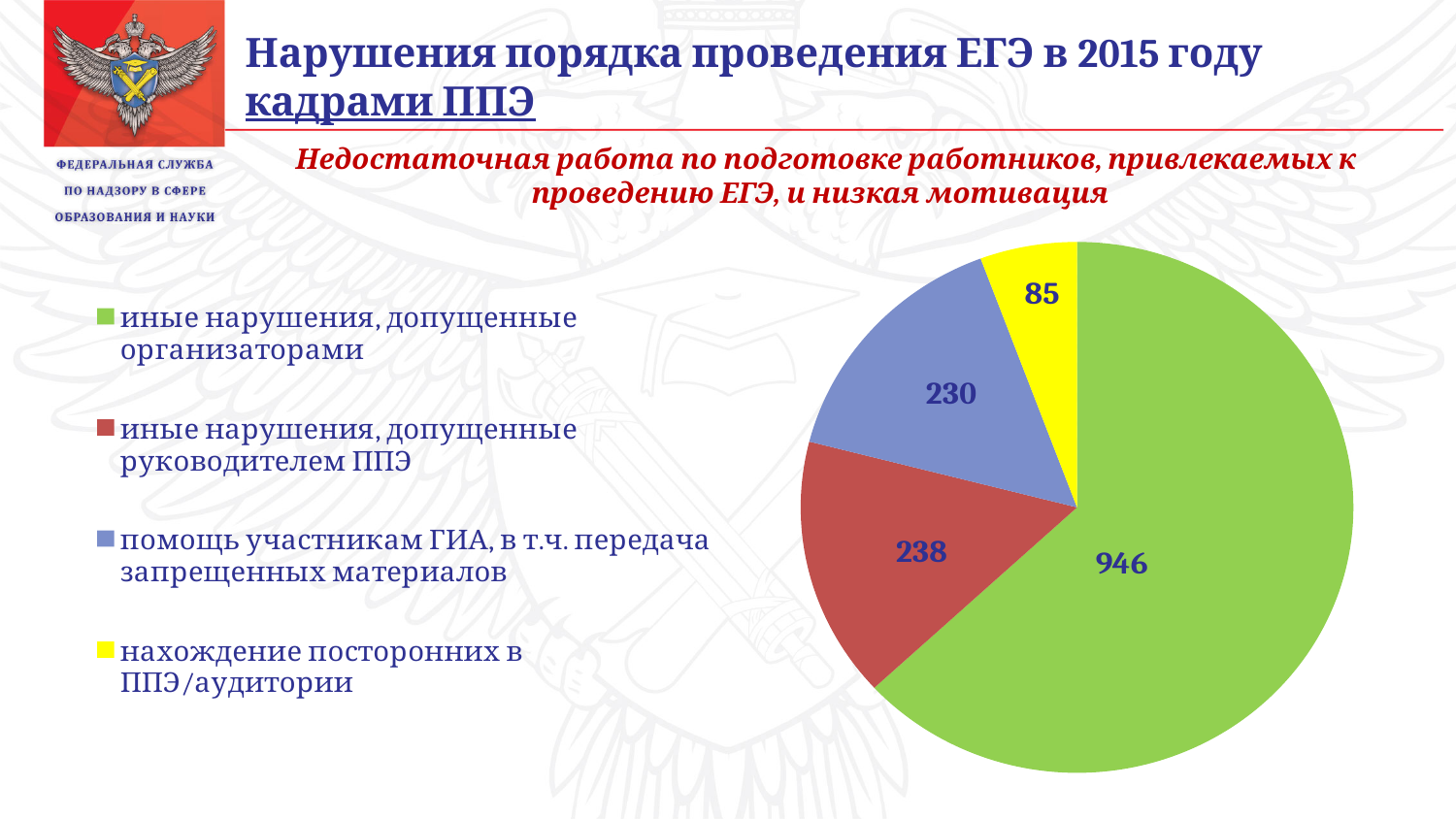
What is the difference between the values for 'иные нарушения, допущенные организаторами' and 'иные нарушения, допущенные руководителем ППЭ'? 708 What is the value for 'иные нарушения, допущенные организаторами'? 946 Which category has the smallest slice of the pie? нахождение посторонних в ППЭ/аудитории What is the total of all four values in the pie chart? 1499 What is the value for 'иные нарушения, допущенные руководителем ППЭ'? 238 How many slices does the pie chart have? 4 What is the value for 'нахождение посторонних в ППЭ/аудитории'? 85 What is the value for 'помощь участникам ГИА, в т.ч. передача запрещенных материалов'? 230 Which category has the largest slice of the pie? иные нарушения, допущенные организаторами What type of chart is shown on the slide? Pie chart What colour is the slice for 'нахождение посторонних в ППЭ/аудитории'? Yellow Which is larger: the value for 'иные нарушения, допущенные руководителем ППЭ' or the value for 'помощь участникам ГИА, в т.ч. передача запрещенных материалов'? иные нарушения, допущенные руководителем ППЭ